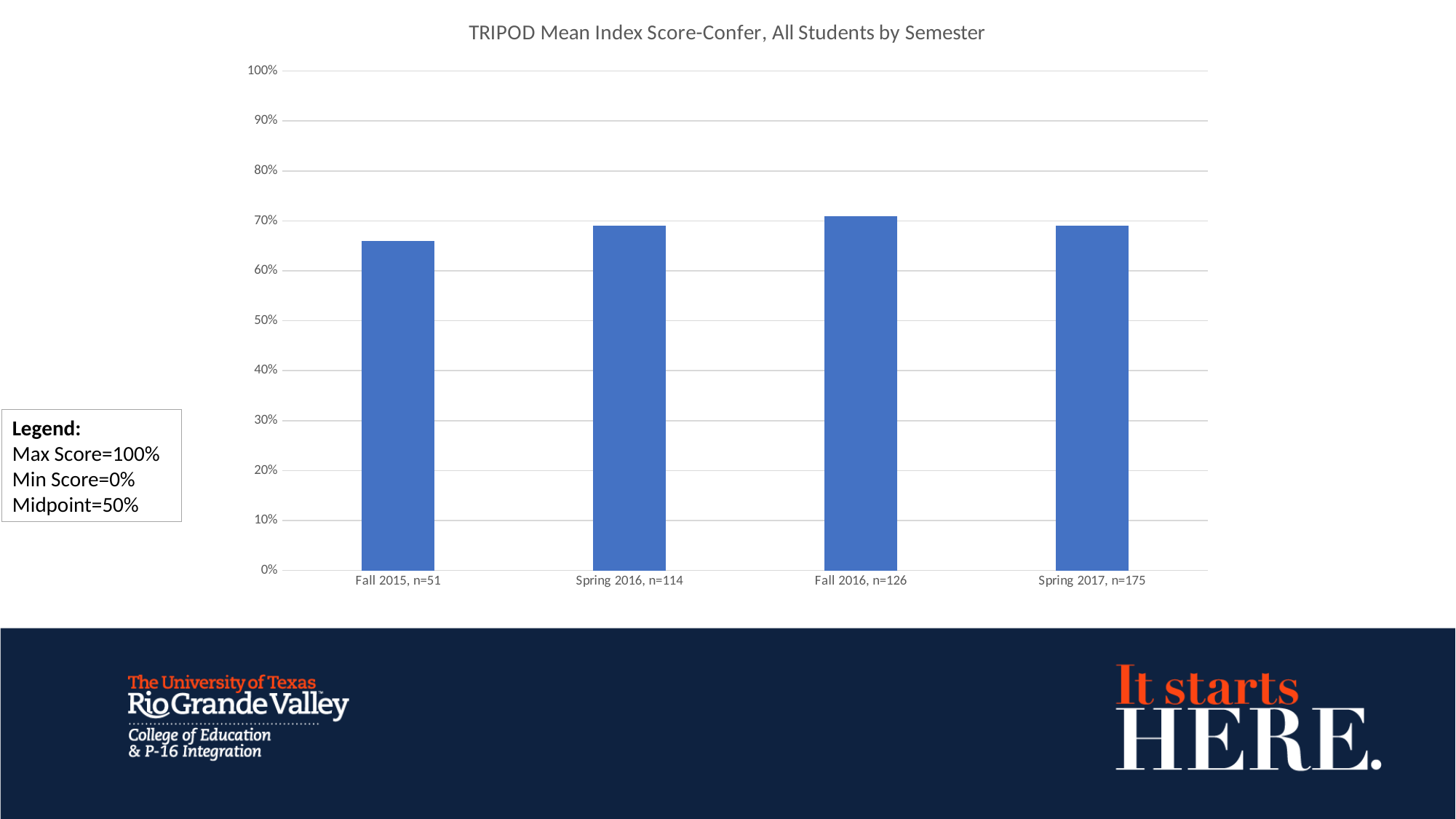
According to the legend box on the slide, what is the midpoint score? 50% What type of chart is shown on the slide? bar chart How many semesters (bars) are plotted in the chart? 4 Does the mean index score rise or fall from Fall 2015 to Fall 2016? rise Which semester has the lowest mean index score? Fall 2015, n=51 Is the value for Spring 2017 greater or less than 50%? greater Is the value for Fall 2016 greater or less than 60%? greater Is the value for Fall 2015 greater or less than 60%? greater Which is larger, the value for Fall 2015 or the value for Fall 2016? Fall 2016 What is the title of the chart? TRIPOD Mean Index Score-Confer, All Students by Semester Which semester has the highest mean index score? Fall 2016, n=126